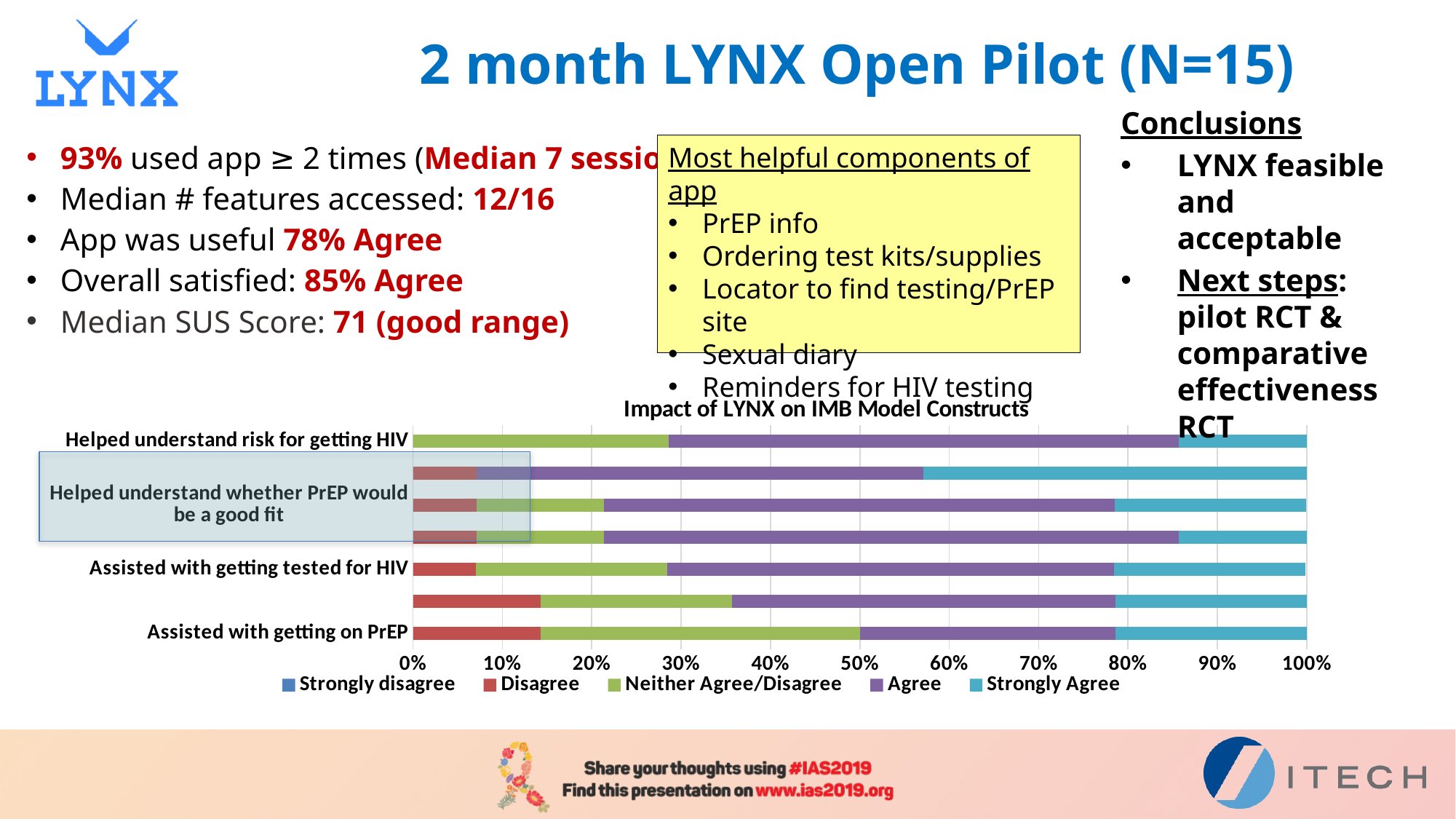
In the 'Impact of LYNX on IMB Model Constructs' chart, is the Agree share for 'Helped understand risk for getting HIV' greater or less than 50%? greater How many bars are plotted in the 'Impact of LYNX on IMB Model Constructs' chart? 7 What is the maximum value shown on the x axis of the 'Impact of LYNX on IMB Model Constructs' chart? 100% What is the title of the chart on the slide? Impact of LYNX on IMB Model Constructs In the 'Impact of LYNX on IMB Model Constructs' chart, for 'Assisted with getting on PrEP', which is larger: the Disagree share or the Neither Agree/Disagree share? Neither Agree/Disagree In the 'Impact of LYNX on IMB Model Constructs' chart, is the Strongly Agree share for 'Assisted with getting on PrEP' greater or less than 30%? less In the 'Impact of LYNX on IMB Model Constructs' chart, is the Neither Agree/Disagree share for 'Helped understand risk for getting HIV' greater or less than 20%? greater In the 'Impact of LYNX on IMB Model Constructs' chart, for 'Helped understand risk for getting HIV', which is larger: the Agree share or the Strongly Agree share? Agree What type of chart is 'Impact of LYNX on IMB Model Constructs'? Stacked bar chart How many series does the legend of the 'Impact of LYNX on IMB Model Constructs' chart list? 5